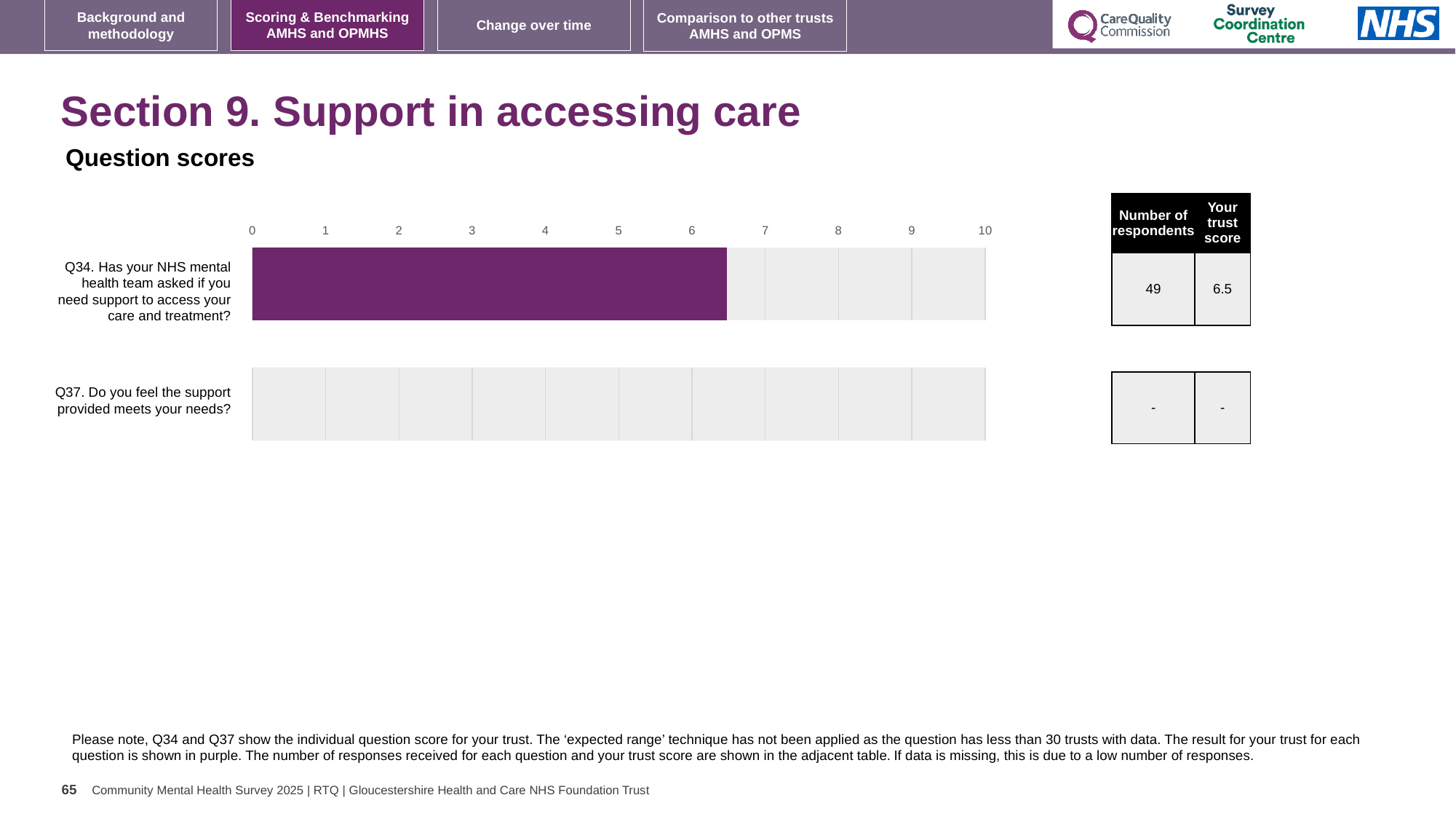
How many respondents answered Q34? 49 What is the trust score for Q34 (Has your NHS mental health team asked if you need support to access your care and treatment?)? 6.5 What is shown in the table for Q37 (Do you feel the support provided meets your needs?) under 'Your trust score'? - Is the value for Q34 greater or less than 7? less What is the maximum value shown on the chart's x axis? 10 Is the value for Q34 greater or less than 5? greater What is the number of respondents shown for Q37? - Which question has a purple bar plotted on the chart? Q34 What type of chart is shown on the slide? bar chart How many questions (categories) are listed on the chart? 2